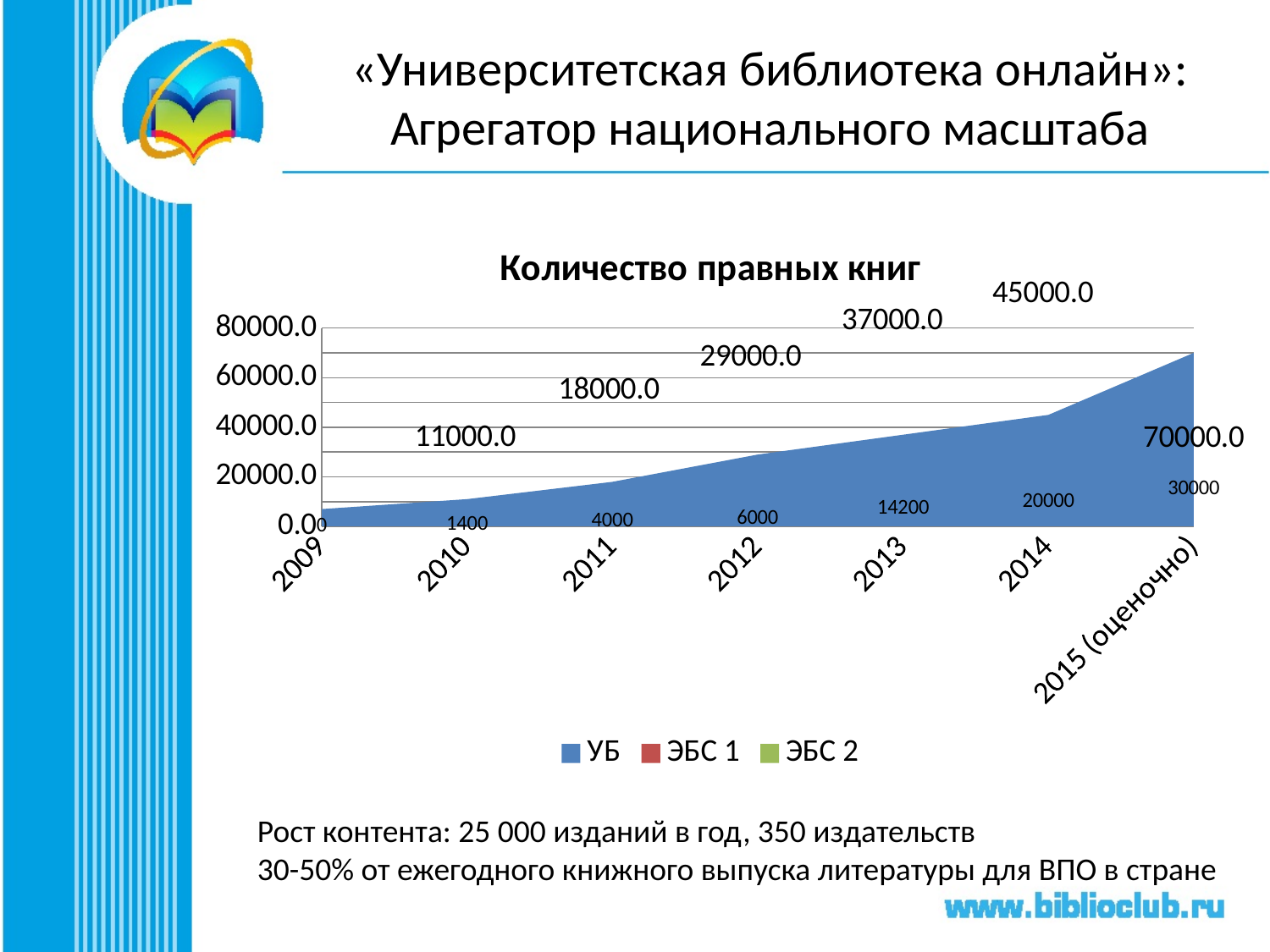
What is the value for УБ in 2014? 45000.0 Which year has the lowest value for УБ? 2009 What kind of chart is shown? area chart What is the value for УБ in 2015 (оценочно)? 70000.0 What is the value for УБ in 2010? 11000.0 How many years are shown on the x axis? 7 What is the difference between the УБ values for 2015 (оценочно) and 2014? 25000.0 Is the value for УБ in 2009 greater or less than 20000? less What is the value for УБ in 2012? 29000.0 Which year has the highest value for УБ? 2015 (оценочно) How many series does the legend list? 3 Which is larger, the УБ value for 2011 or for 2013? 2013